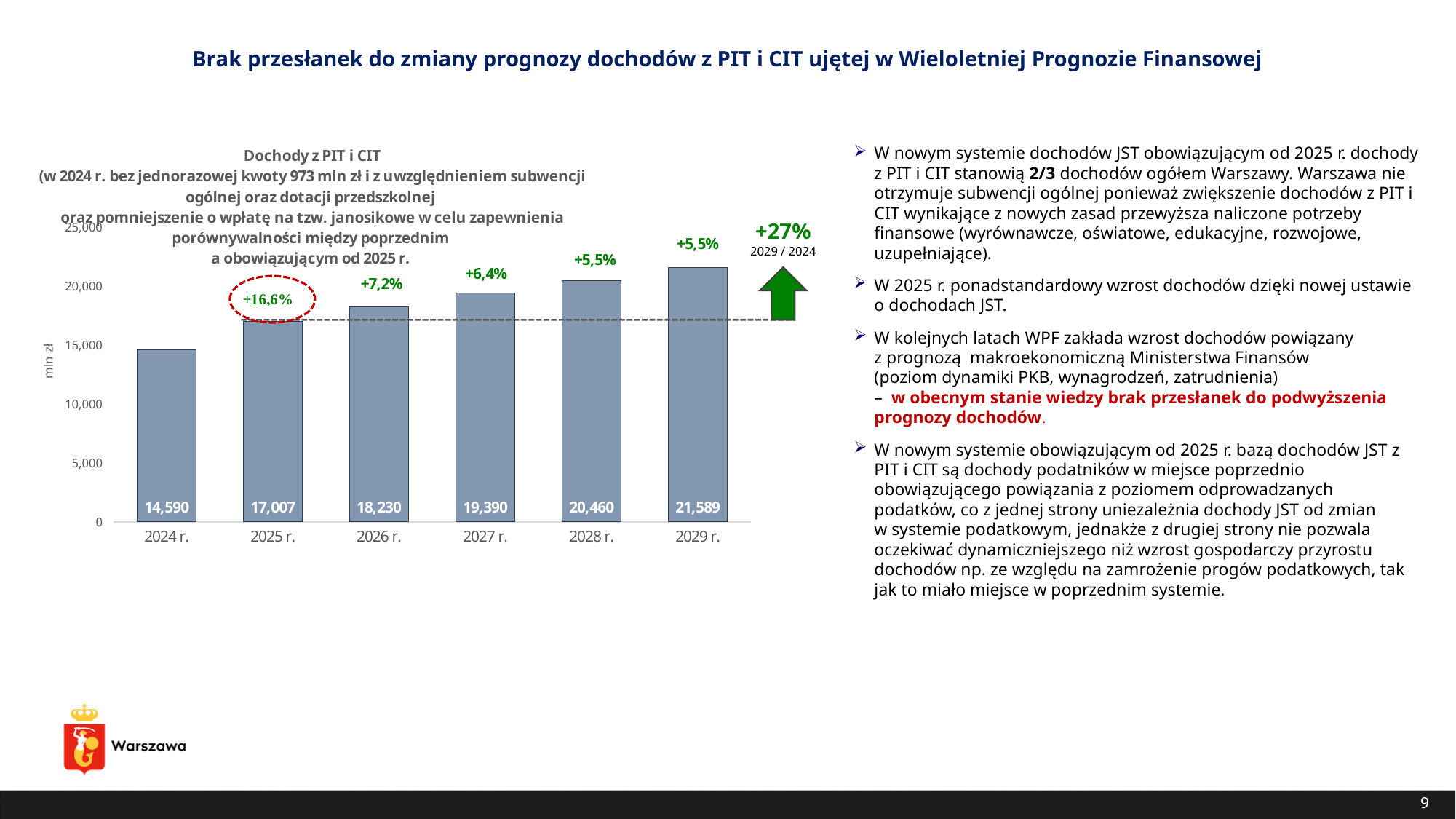
What is the value for 2027 r.? 19,390 What kind of chart is shown? bar chart What is the difference between the values for 2025 r. and 2024 r.? 2,417 What is the value for 2024 r.? 14,590 Which is larger, the value for 2026 r. or the value for 2028 r.? 2028 r. Is the value for 2027 r. greater or less than 20,000? less What is the value for 2029 r.? 21,589 What is the difference between the values for 2029 r. and 2028 r.? 1,129 Do the values rise or fall from 2024 r. to 2029 r.? rise How many years are shown on the x axis? 6 Which year has the highest value? 2029 r. Which year has the lowest value? 2024 r.